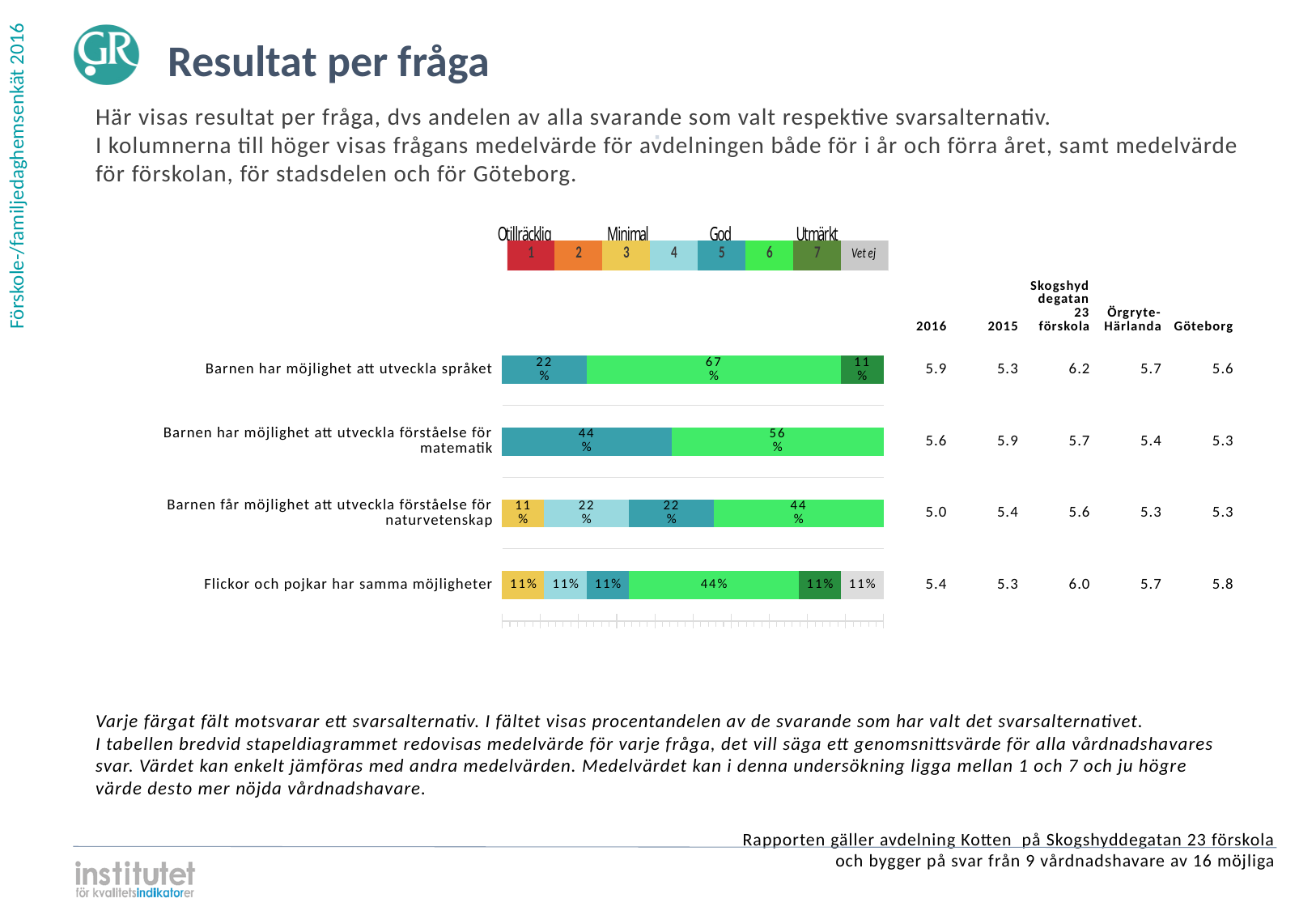
How many questions (bars) are shown in the chart? 4 What is the difference between the share choosing answer 6 and the share choosing answer 5 for "Barnen har möjlighet att utveckla språket"? 45 percentage points What percentage of respondents answered "Vet ej" for "Flickor och pojkar har samma möjligheter"? 11% Which question has the largest single segment in its bar? Barnen har möjlighet att utveckla språket What is the 2016 mean value shown for "Barnen får möjlighet att utveckla förståelse för naturvetenskap"? 5.0 How many answer alternatives does the legend list? 8 For "Barnen har möjlighet att utveckla förståelse för matematik", which is larger: the share for answer 5 or the share for answer 6? Answer 6 What percentage of respondents chose answer 3 (yellow) for "Barnen får möjlighet att utveckla förståelse för naturvetenskap"? 11% What is the total of the segments in the bar for "Barnen har möjlighet att utveckla språket"? 100% What percentage of respondents chose answer 5 (teal) for "Barnen har möjlighet att utveckla förståelse för matematik"? 44% What percentage of respondents chose answer 6 (green) for "Barnen har möjlighet att utveckla språket"? 67% What kind of chart is used to show the results per question? Stacked bar chart